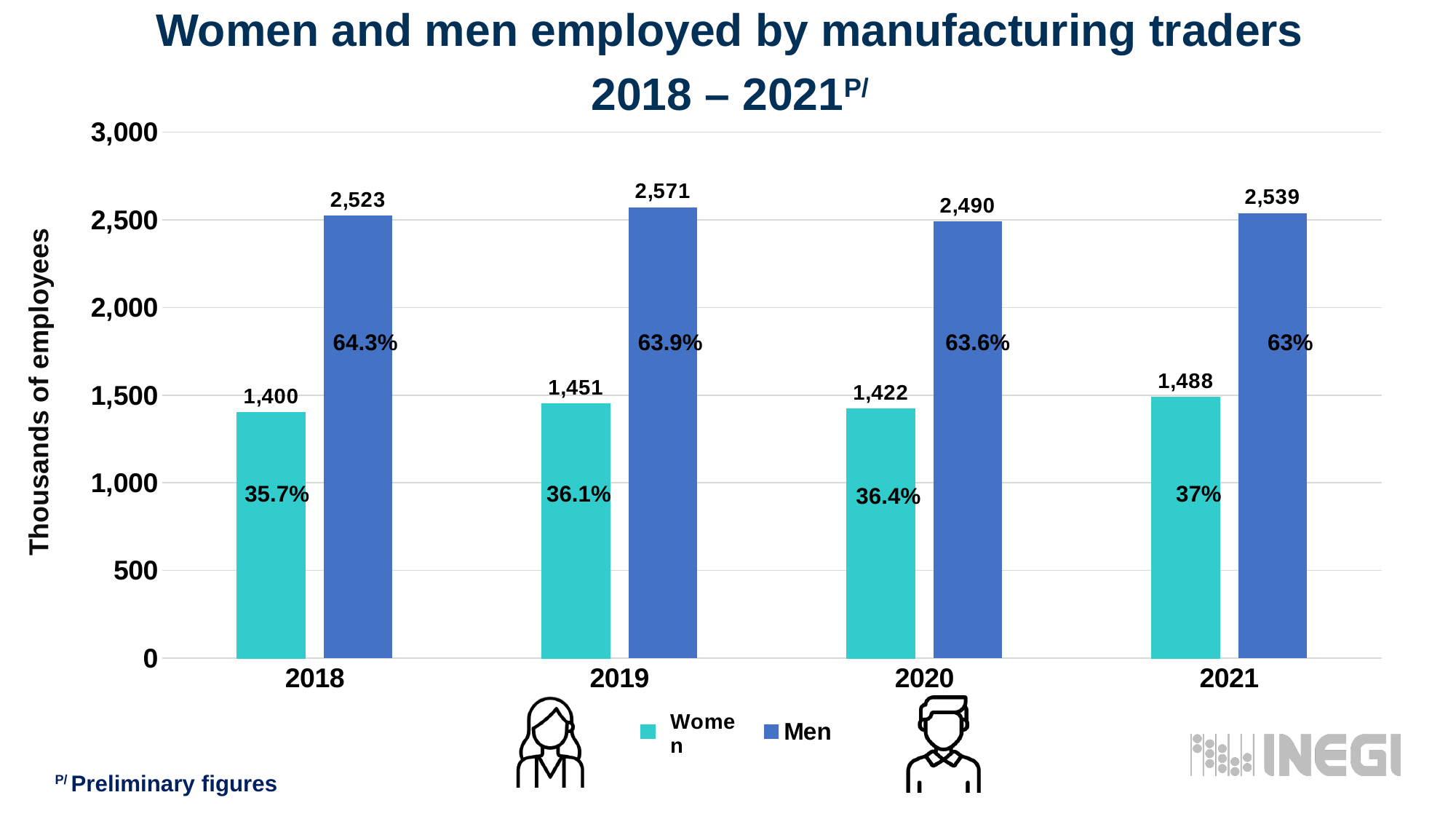
Which is larger, the value for Women in 2019 or the value for Women in 2020? Women in 2019 What is the difference between the Men and Women values in 2021? 1,051 What is the value for Men in 2019? 2,571 What percentage share is shown on the Women bar for 2021? 37% How many series does the legend list? 2 What kind of chart is shown on the slide? Bar chart How many years are shown on the x axis? 4 In which year is the value for Women the lowest? 2018 In which year is the value for Men the highest? 2019 What is the value for Women in 2018? 1,400 What is the label of the vertical axis? Thousands of employees What percentage share is shown on the Men bar for 2020? 63.6%